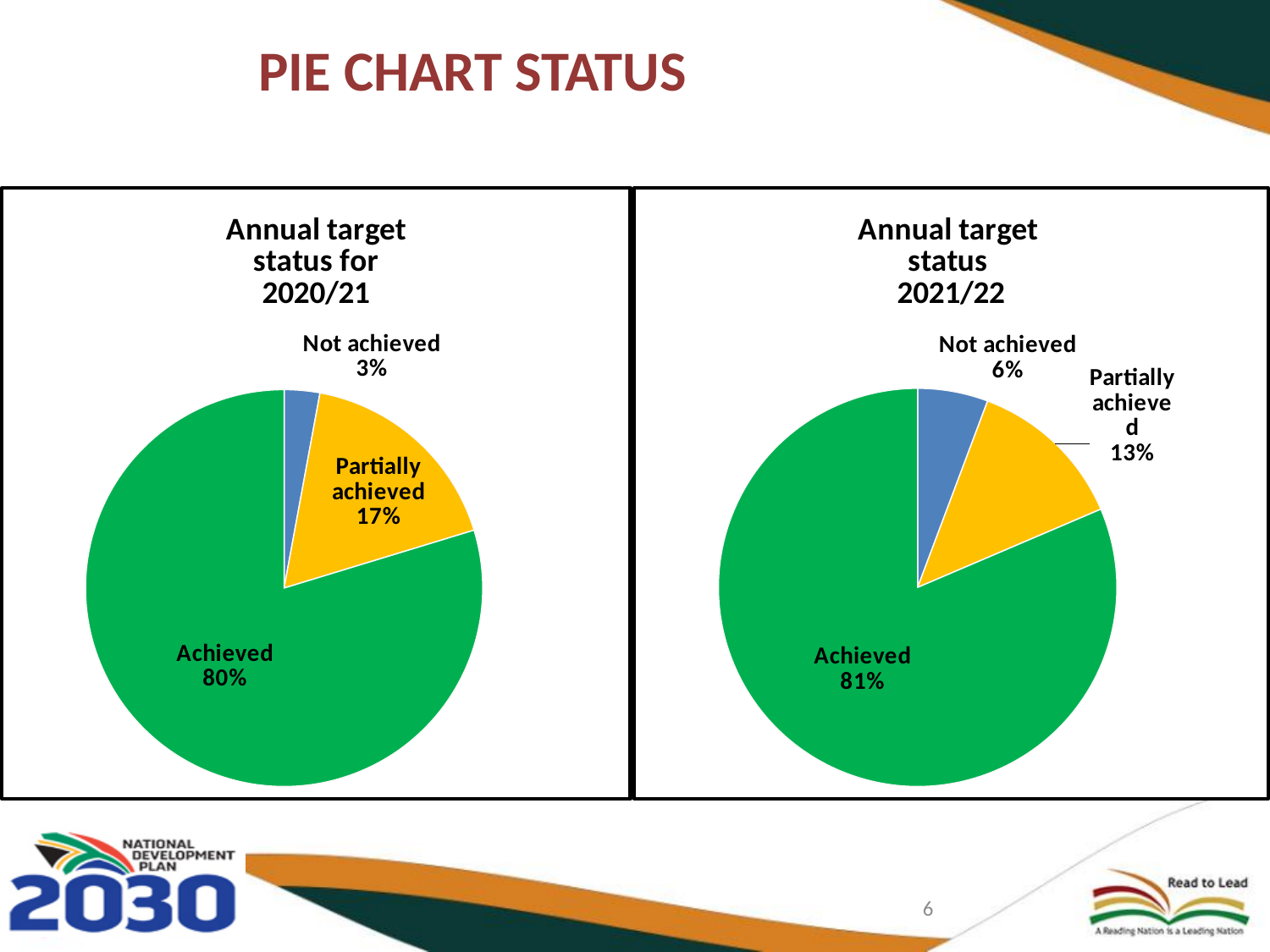
How many categories does the 'Annual target status for 2020/21' chart show? 3 Is the 'Not achieved' value larger in the 2020/21 chart or the 2021/22 chart? 2021/22 In the 'Annual target status for 2020/21' chart, what is the value for 'Not achieved'? 3% In the 'Annual target status for 2020/21' chart, which category has the smallest slice? Not achieved In the 'Annual target status 2021/22' chart, what share of the pie is 'Achieved'? 81% In the 'Annual target status 2021/22' chart, what is the value for 'Not achieved'? 6% In the 'Annual target status for 2020/21' chart, what is the value for 'Partially achieved'? 17% In the 'Annual target status for 2020/21' chart, what share of the pie is 'Achieved'? 80% What type of chart is the 'Annual target status 2021/22' chart? Pie chart In the 'Annual target status 2021/22' chart, which category has the largest slice? Achieved In the 'Annual target status 2021/22' chart, what is the value for 'Partially achieved'? 13% In the 'Annual target status 2021/22' chart, what is the difference between 'Partially achieved' and 'Not achieved'? 7%